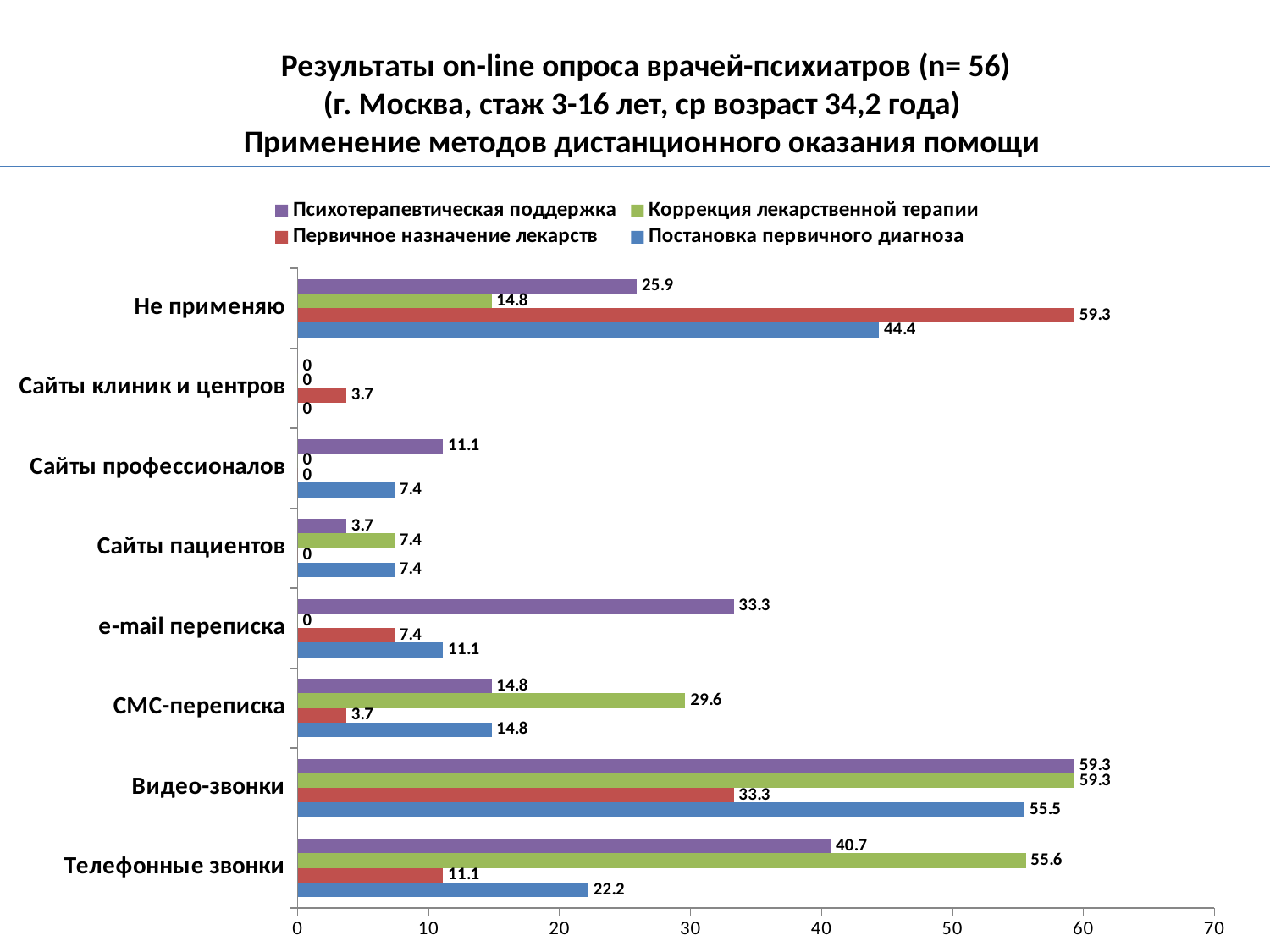
What is the value for Первичное назначение лекарств in the Не применяю category? 59.3 Which series is shown in green in the legend? Коррекция лекарственной терапии How many series does the legend list? 4 What is the value for Коррекция лекарственной терапии in the Телефонные звонки category? 55.6 What kind of chart is shown on the slide? bar chart What is the value for Постановка первичного диагноза in the Видео-звонки category? 55.5 Which category has the lowest value for Постановка первичного диагноза? Сайты клиник и центров Which category has the highest value for Коррекция лекарственной терапии? Видео-звонки In the СМС-переписка category, which is larger: Коррекция лекарственной терапии or Первичное назначение лекарств? Коррекция лекарственной терапии How many categories are shown on the vertical axis? 8 What is the value for Психотерапевтическая поддержка in the e-mail переписка category? 33.3 What is the difference between Психотерапевтическая поддержка and Постановка первичного диагноза in the Телефонные звонки category? 18.5